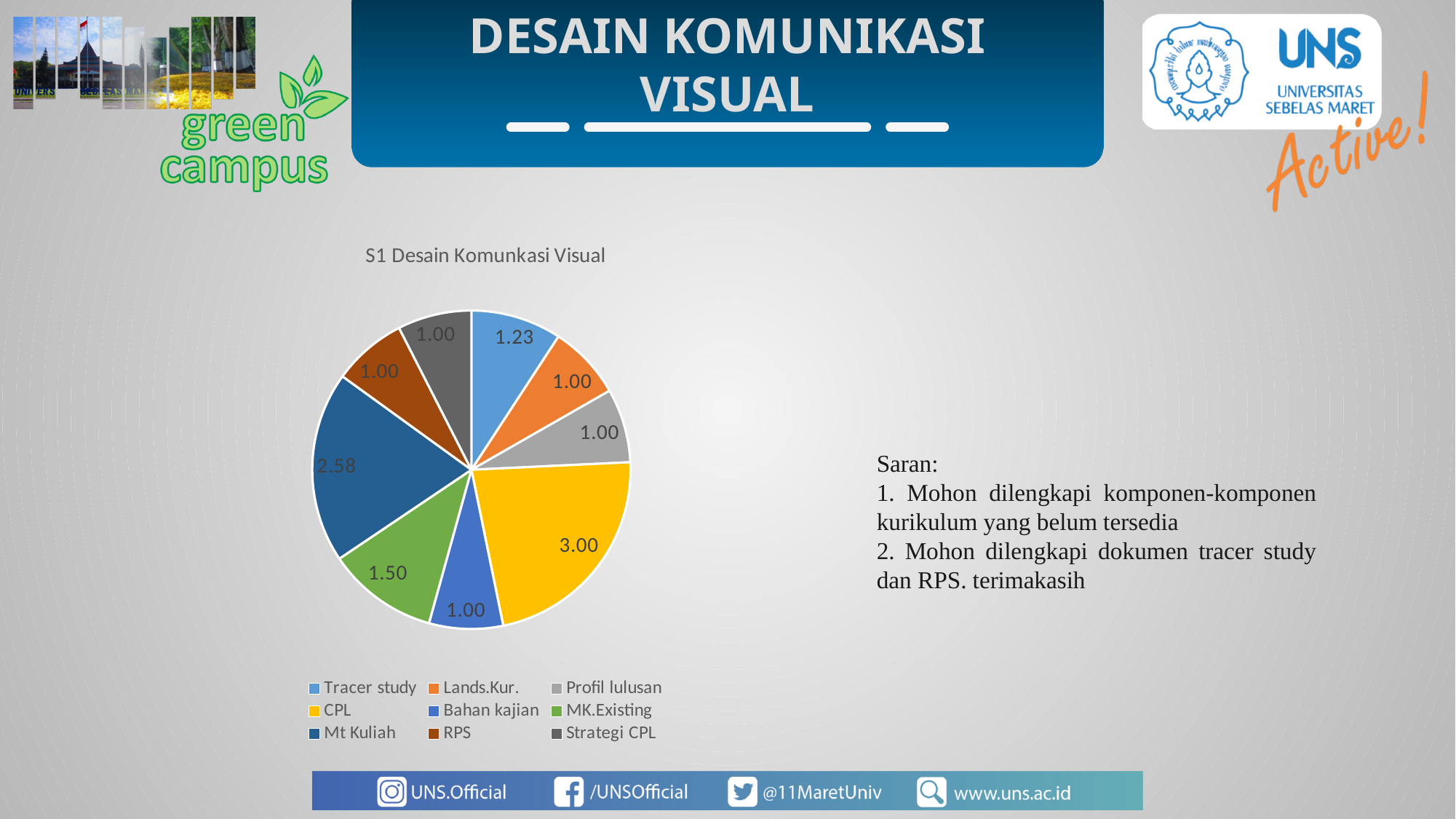
What is the difference between the values for CPL and Mt Kuliah? 0.42 What is the difference between the values for MK.Existing and Tracer study? 0.27 How many categories are shown in the pie chart? 9 What is the total of all the slice values in the pie chart? 13.31 What is the value for Mt Kuliah in the pie chart? 2.58 Which is larger, the value for Mt Kuliah or the value for MK.Existing? Mt Kuliah What type of chart is shown on the slide? pie chart Which category has the largest slice in the pie chart? CPL What is the value for CPL in the pie chart? 3.00 What is the value for Tracer study in the pie chart? 1.23 What is the title of the pie chart? S1 Desain Komunkasi Visual What is the value for MK.Existing in the pie chart? 1.50